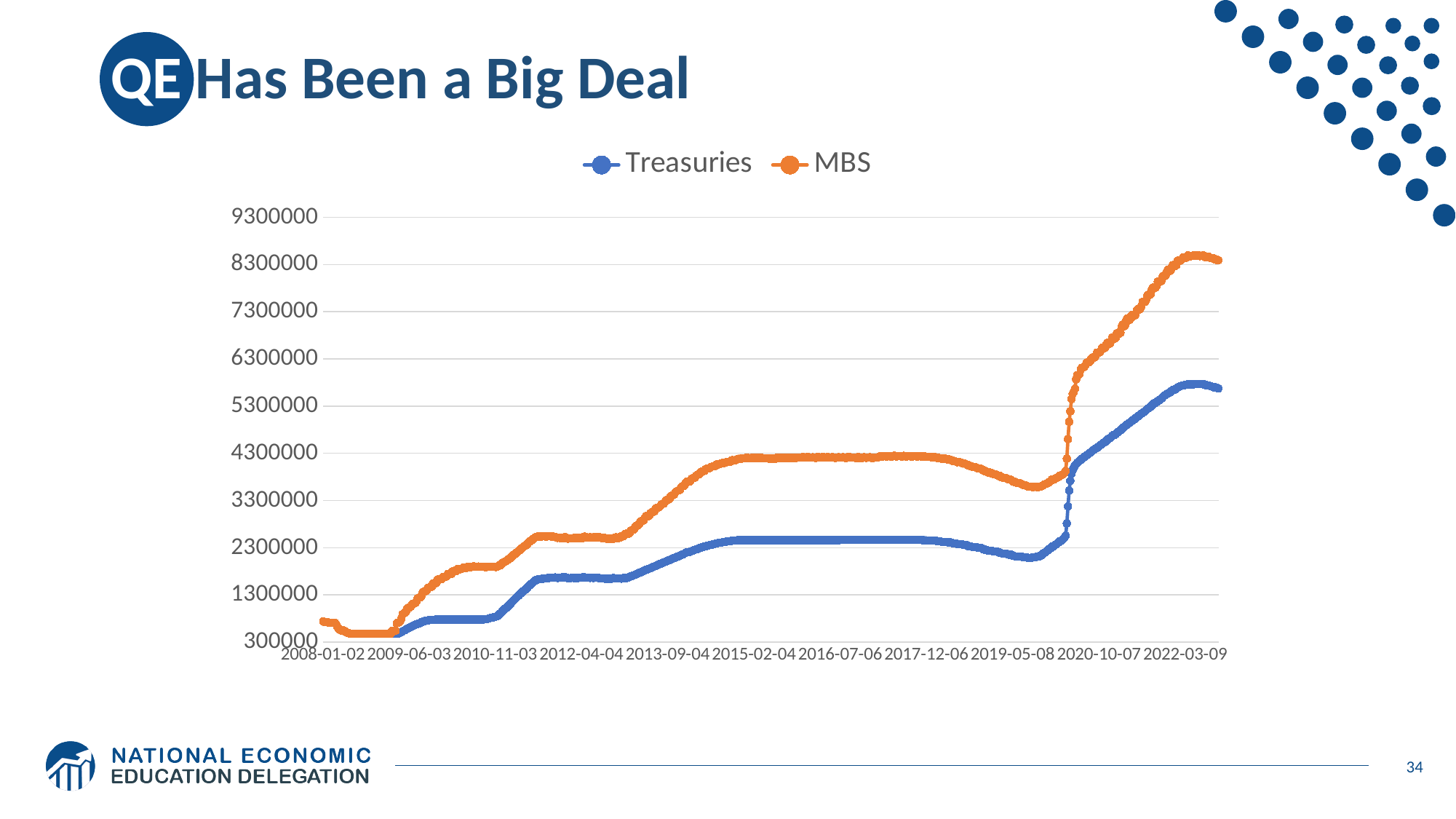
Is the value for Treasuries at 2022-03-09 greater or less than 5300000? greater What kind of chart is shown on the slide? line chart What is the title of the slide containing the chart? QE Has Been a Big Deal Is the value for Treasuries at 2015-02-04 greater or less than 3300000? less Does the MBS series rise or fall between 2017-12-06 and 2019-05-08? fall Which two series are listed in the chart legend? Treasuries and MBS Does the Treasuries series rise or fall between 2019-05-08 and 2022-03-09? rise Is the value for Treasuries at 2012-04-04 greater or less than 1300000? greater How many series does the legend list? 2